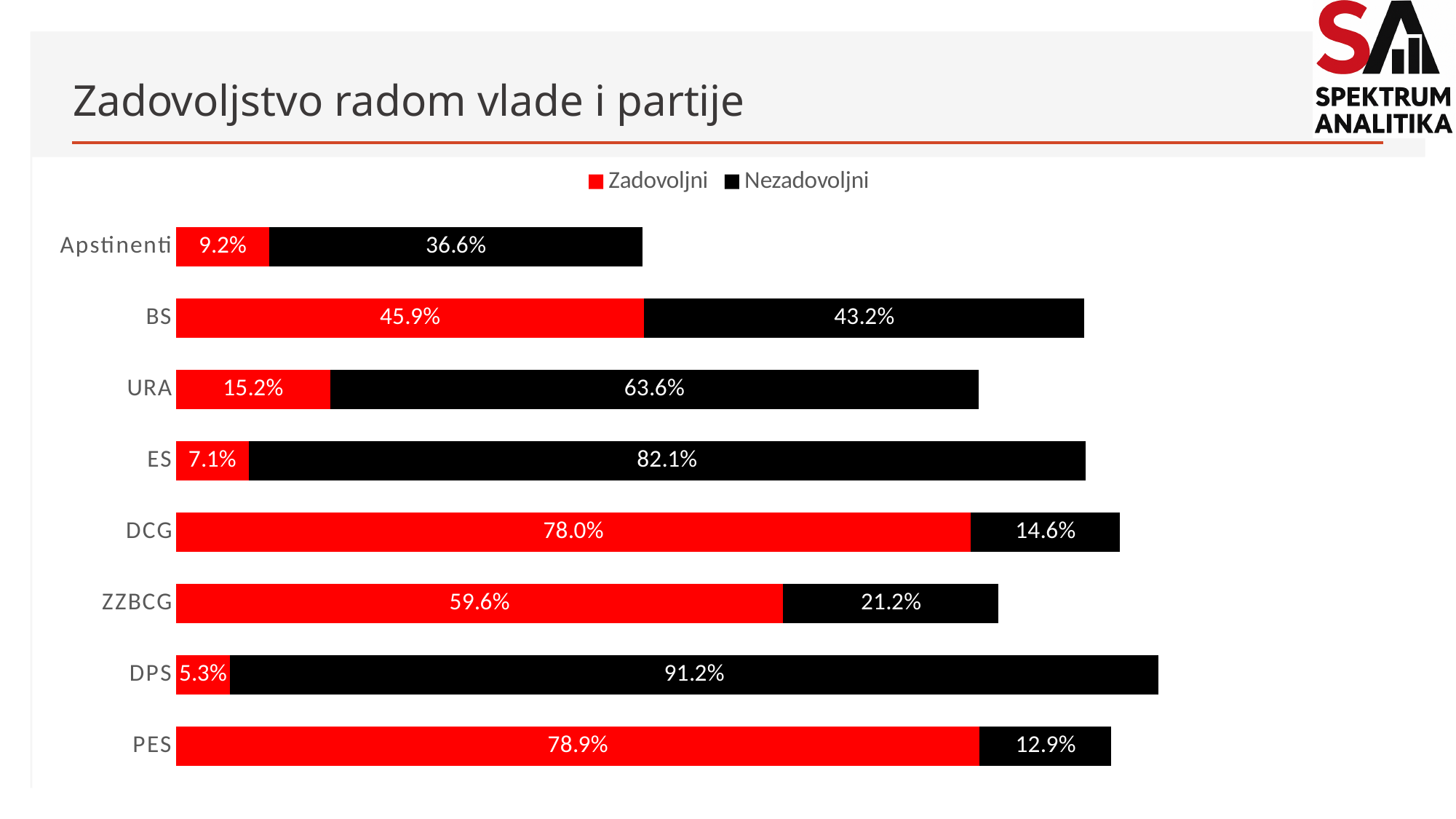
How many categories are shown on the chart? 8 How many series does the legend list? 2 What is the total of the stacked bar for DCG? 92.6% What is the Zadovoljni value for ZZBCG? 59.6% What kind of chart is shown on the slide? Stacked bar chart What is the Zadovoljni value for BS? 45.9% Which is larger for BS: the Zadovoljni value or the Nezadovoljni value? Zadovoljni Which category has the lowest Nezadovoljni value? PES Which category has the lowest Zadovoljni value? DPS What is the difference between the Nezadovoljni and Zadovoljni values for URA? 48.4% What is the Nezadovoljni value for DPS? 91.2% Which category has the highest Zadovoljni value? PES